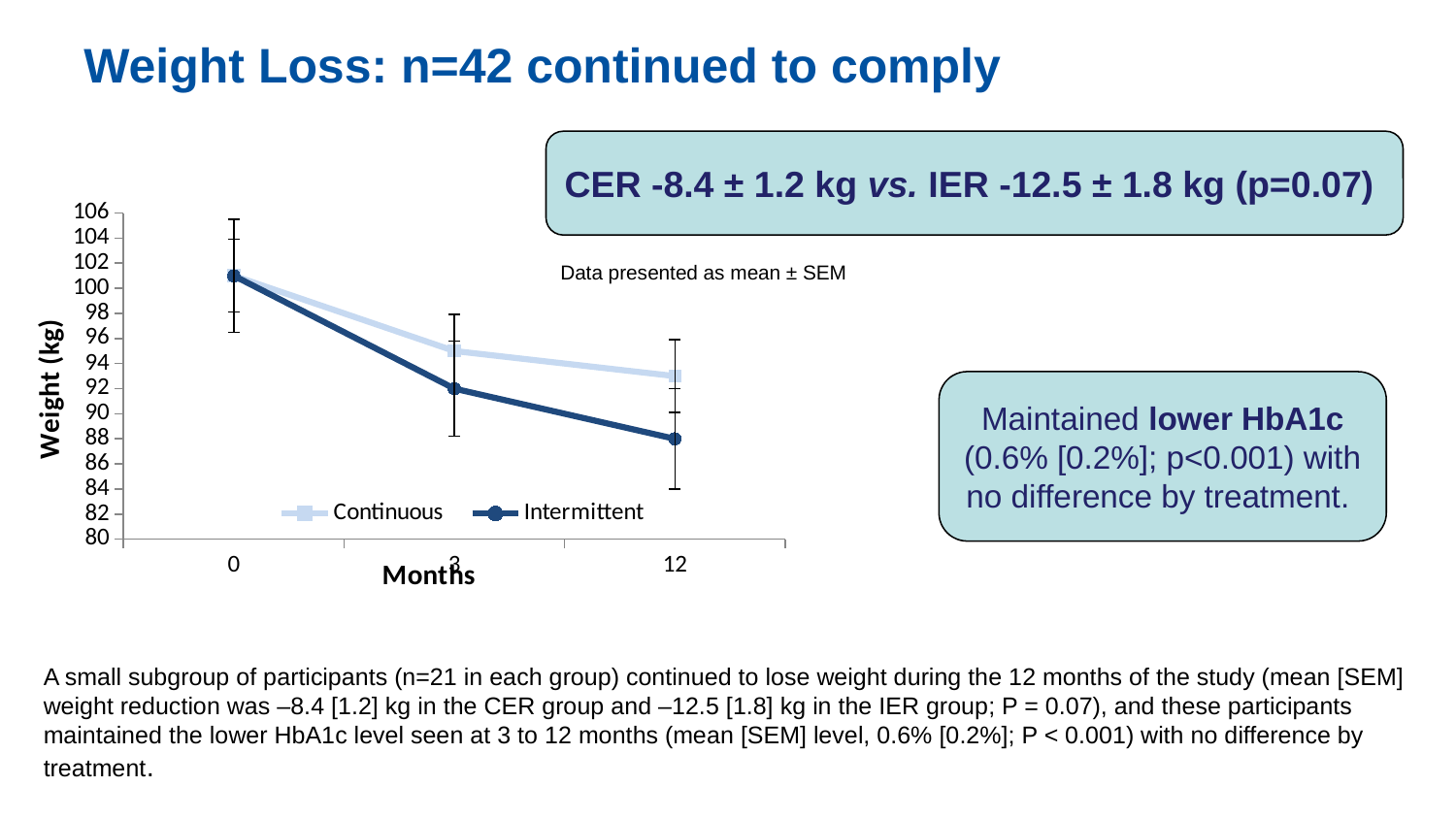
What kind of chart is shown on the slide? line chart Does the Intermittent series rise or fall from 0 to 12 months? fall Is the Continuous value at 3 months greater or less than 90? greater At 12 months, which series has the higher weight, Continuous or Intermittent? Continuous What is the label on the y axis of the chart? Weight (kg) What is the label on the x axis of the chart? Months How many time points are plotted along the x axis of the chart? 3 How many series does the chart legend list? 2 Is the Continuous value at 12 months greater or less than 90? greater Is the Intermittent value at 0 months greater or less than 98? greater